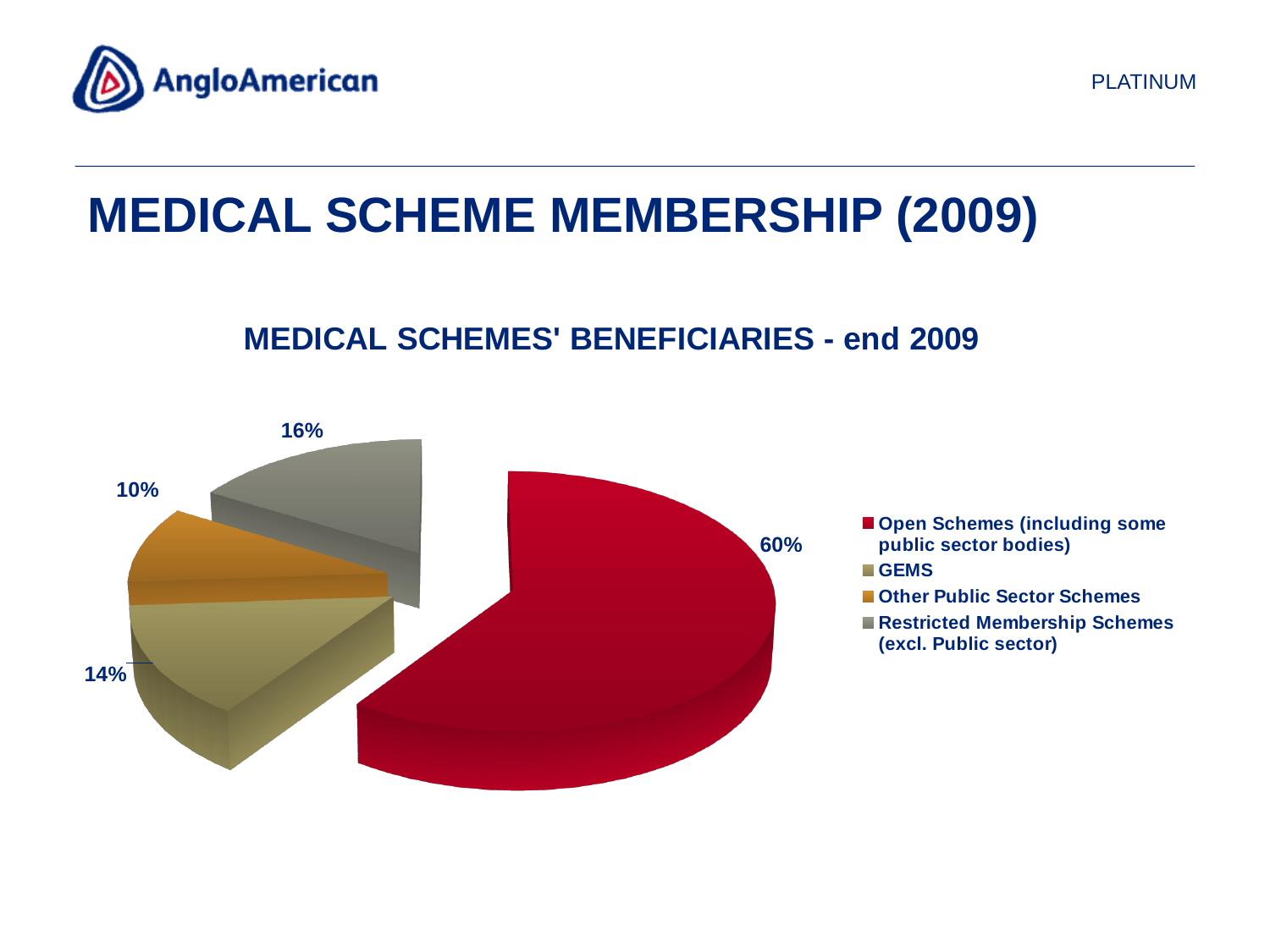
What share of beneficiaries belongs to Open Schemes (including some public sector bodies)? 60% What is the difference in percentage points between the Open Schemes share and the GEMS share? 46 Which has a larger share, GEMS or Restricted Membership Schemes (excl. Public sector)? Restricted Membership Schemes (excl. Public sector) Which category has the largest share of the pie? Open Schemes (including some public sector bodies) What is the chart's title? MEDICAL SCHEMES' BENEFICIARIES - end 2009 What share of beneficiaries belongs to GEMS? 14% What kind of chart is shown on the slide? Pie chart What colour is the slice for Open Schemes (including some public sector bodies)? Red What share of beneficiaries belongs to Other Public Sector Schemes? 10% How many slices does the pie chart have? 4 Which category has the smallest share of the pie? Other Public Sector Schemes